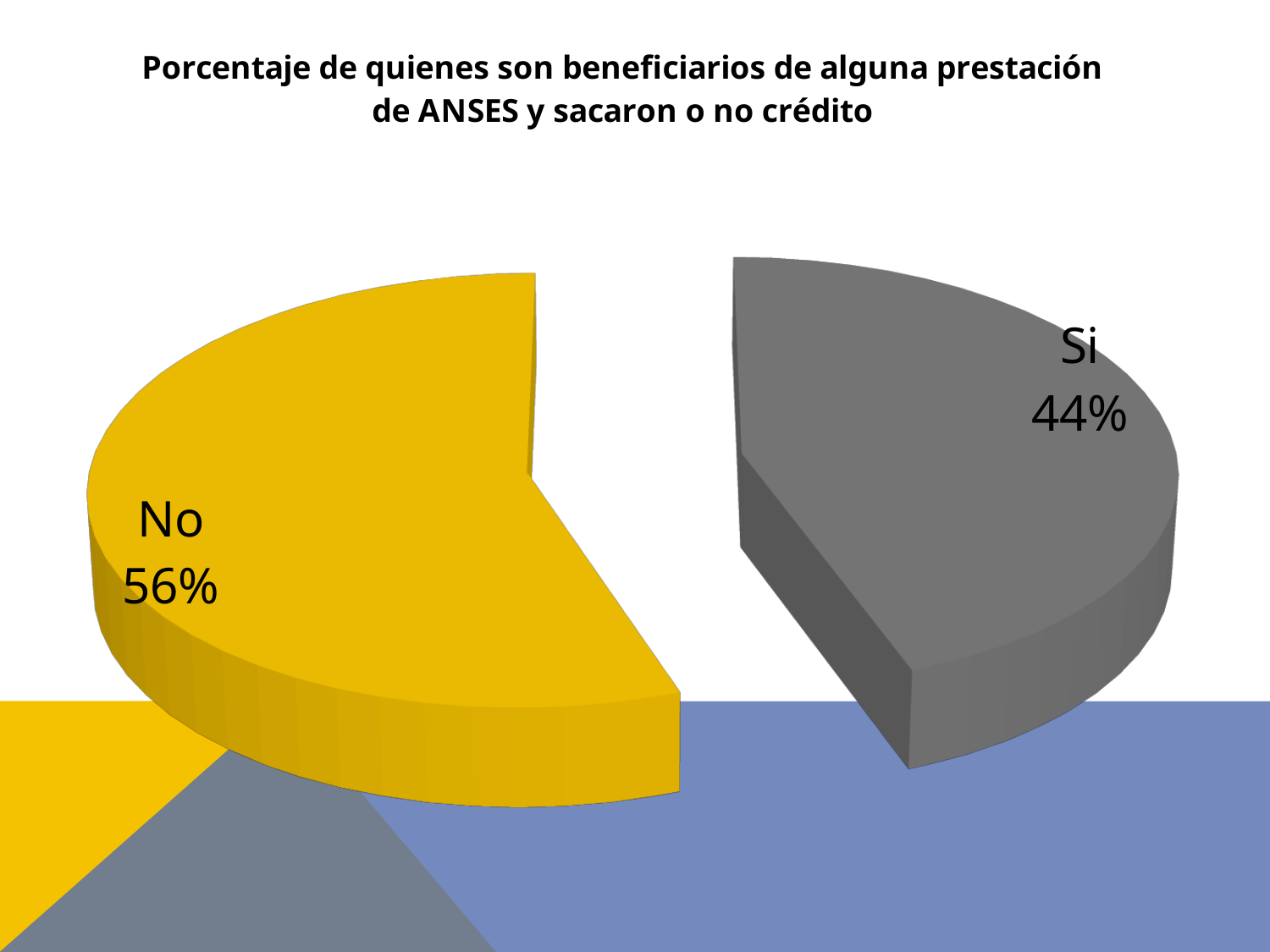
Which slice is the smallest? Si Which is larger, the "Si" slice or the "No" slice? No How many slices does the pie chart have? 2 What percentage of the pie is labelled "Si"? 44% Which slice is the largest? No What kind of chart is shown on the slide? Pie chart What share of the pie does the "Si" slice represent? 44% What percentage of the pie is labelled "No"? 56% What is the title of the chart? Porcentaje de quienes son beneficiarios de alguna prestación de ANSES y sacaron o no crédito What is the difference in percentage points between the "No" slice and the "Si" slice? 12 What colour is the "No" slice? Yellow